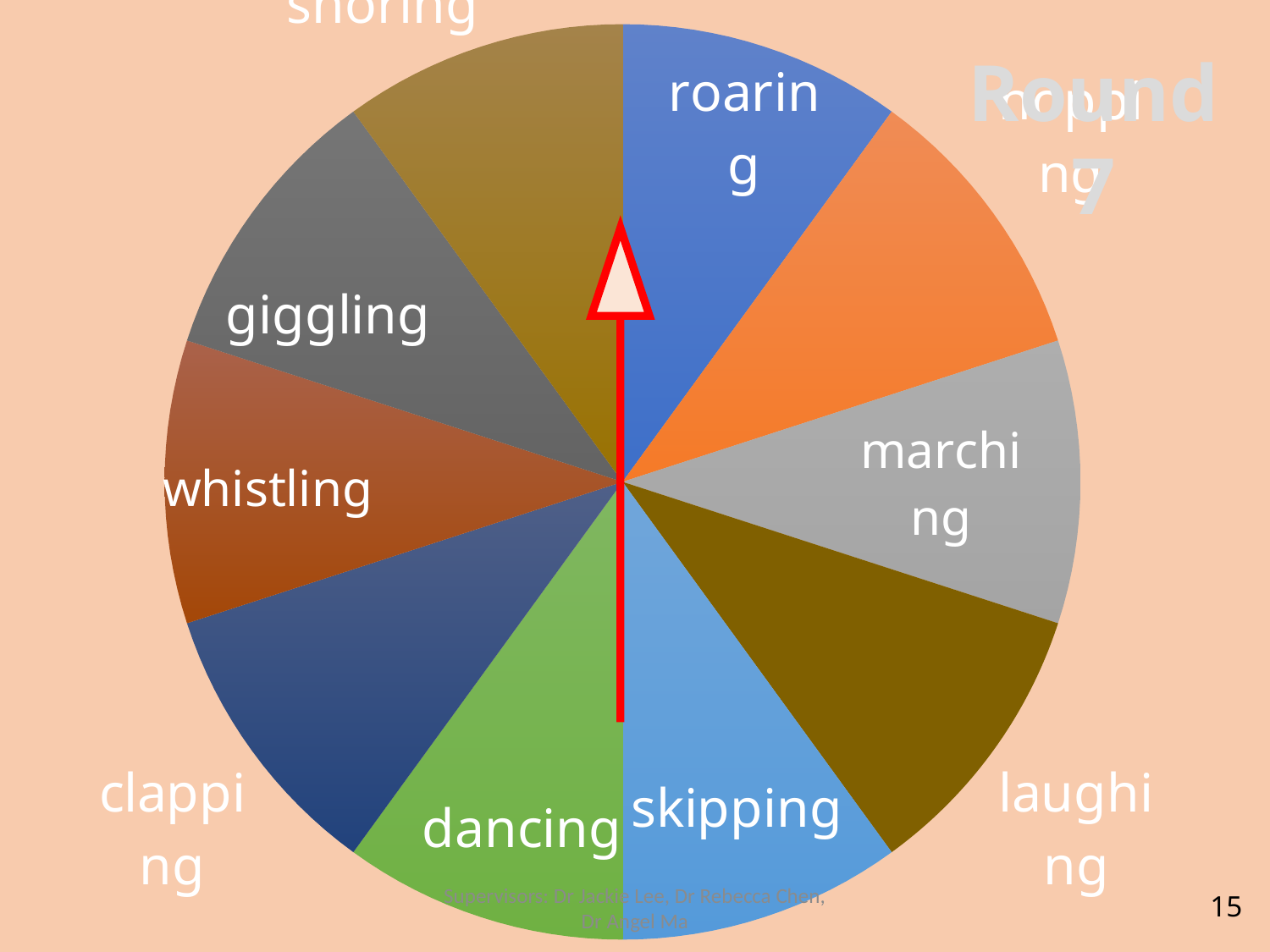
What kind of chart is shown on the slide? pie chart Which slice lies between the whistling slice and the dancing slice? clapping Which slice lies between the marching slice and the skipping slice? laughing Which slice is directly opposite the roaring slice in the pie chart? dancing Which slice is next to the giggling slice going clockwise toward the top of the chart? snoring How many slices does the pie chart have? 10 What colour is the slice labelled skipping? light blue